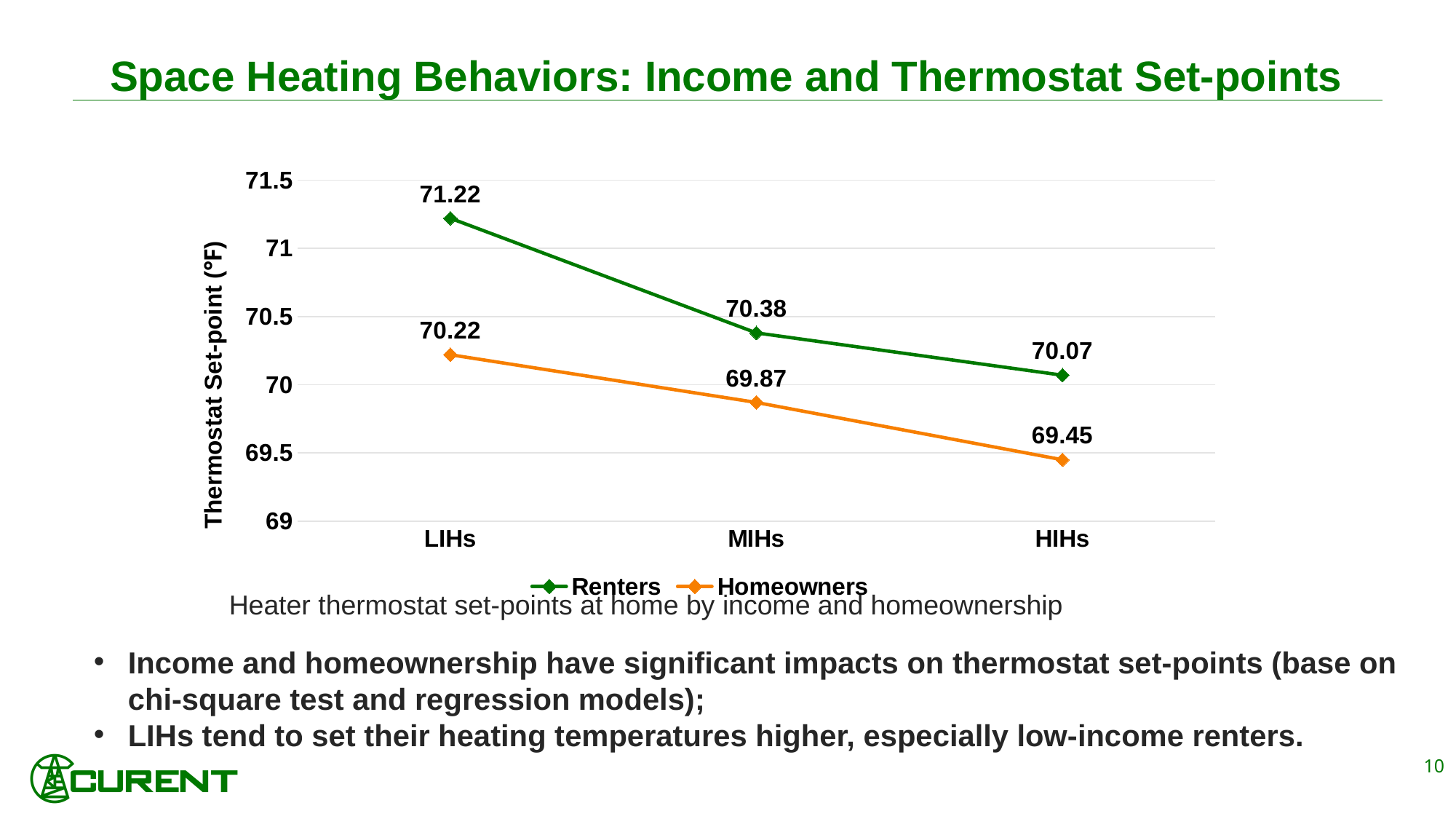
How many series does the legend list? 2 What is the thermostat set-point for Renters in LIHs? 71.22 Which is larger, the Renters set-point in HIHs or the Homeowners set-point in LIHs? Homeowners set-point in LIHs Which income group has the lowest thermostat set-point for Homeowners? HIHs What is the thermostat set-point for Homeowners in HIHs? 69.45 Which income group has the highest thermostat set-point for Renters? LIHs How many income groups are shown on the x axis? 3 What kind of chart is shown on the slide? Line chart What is the thermostat set-point for Homeowners in MIHs? 69.87 What is the difference between the Renters set-point in MIHs and in HIHs? 0.31 Do the Homeowners set-points rise or fall from LIHs to HIHs? Fall What is the difference between the Renters and Homeowners set-points in LIHs? 1.00